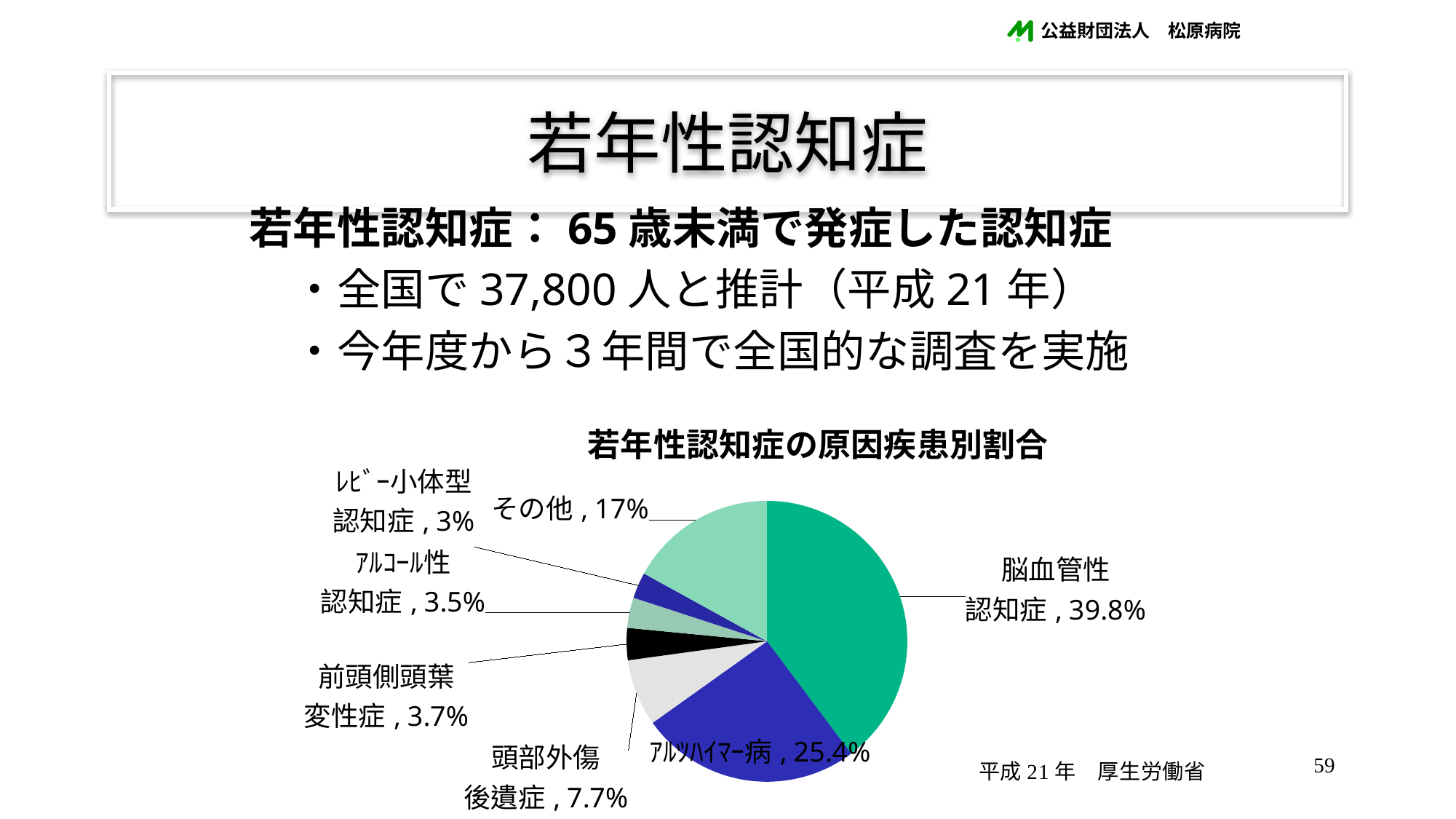
What share of the pie is 頭部外傷後遺症? 7.7% How many slices does the pie chart have? 7 What share of the pie is 脳血管性認知症? 39.8% What share of the pie is その他? 17% What share of the pie is レビー小体型認知症? 3% What share of the pie is アルツハイマー病? 25.4% What is the title of the chart? 若年性認知症の原因疾患別割合 What share of the pie is アルコール性認知症? 3.5% What kind of chart is shown on the slide? pie chart Which category has the largest share of the pie? 脳血管性認知症 What share of the pie is 前頭側頭葉変性症? 3.7% Which category has the smallest share of the pie? レビー小体型認知症